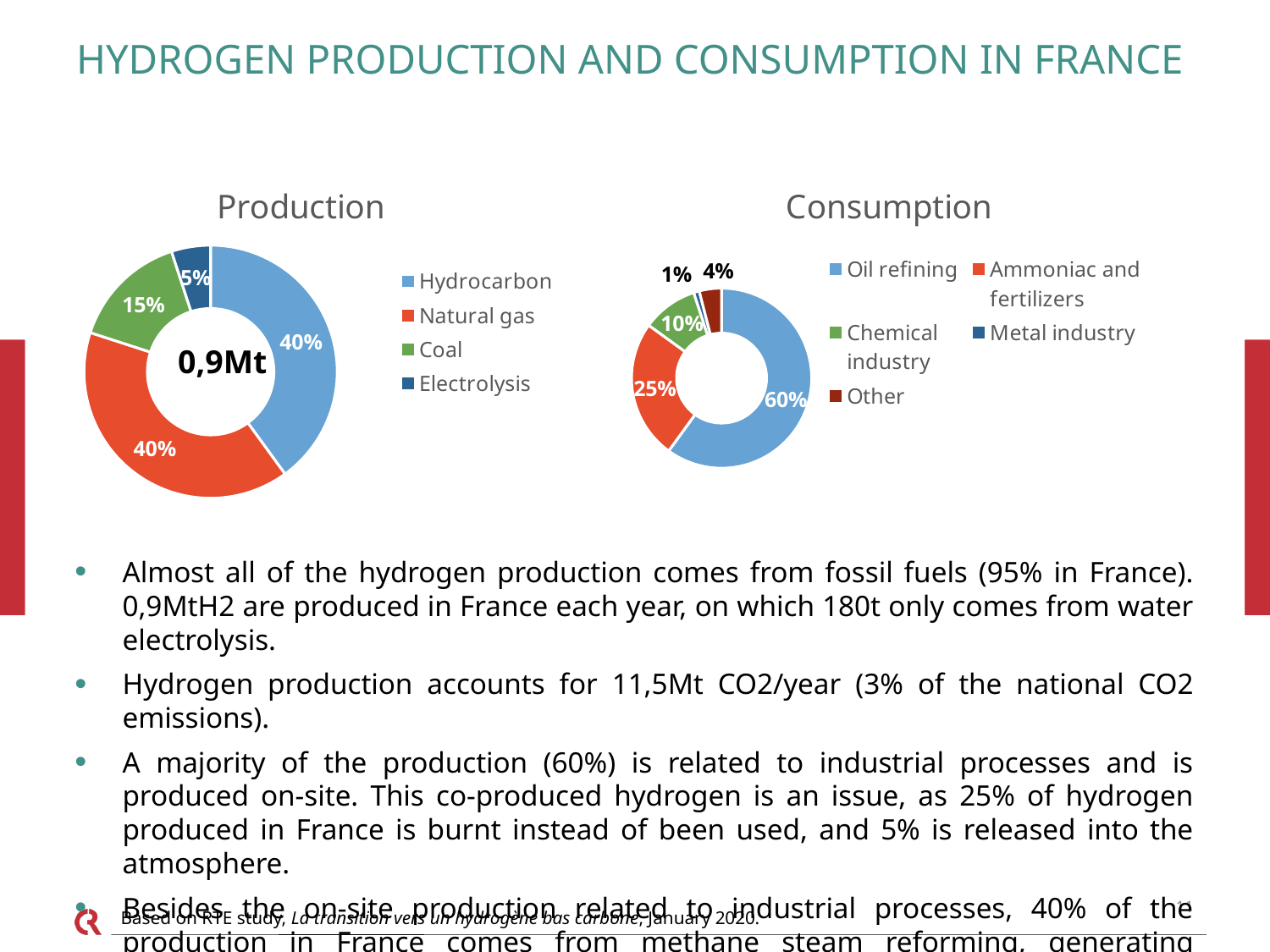
In the Production chart, what share of hydrogen production comes from Electrolysis? 5% In the Production chart, which source has the smallest share? Electrolysis In the Production chart, what is the difference between the Coal share and the Electrolysis share? 10% How many categories does the Production chart's legend list? 4 In the Production chart, what total quantity is shown in the centre of the doughnut? 0,9Mt What type of chart is used for the Consumption data? Doughnut (pie) chart In the Consumption chart, which is larger: Chemical industry or Other? Chemical industry In the Consumption chart, what share of hydrogen consumption goes to Oil refining? 60% In the Consumption chart, which category has the largest share? Oil refining In the Consumption chart, what share goes to Ammoniac and fertilizers? 25% In the Consumption chart, which category has the smallest share? Metal industry In the Production chart, what share of hydrogen production comes from Coal? 15%